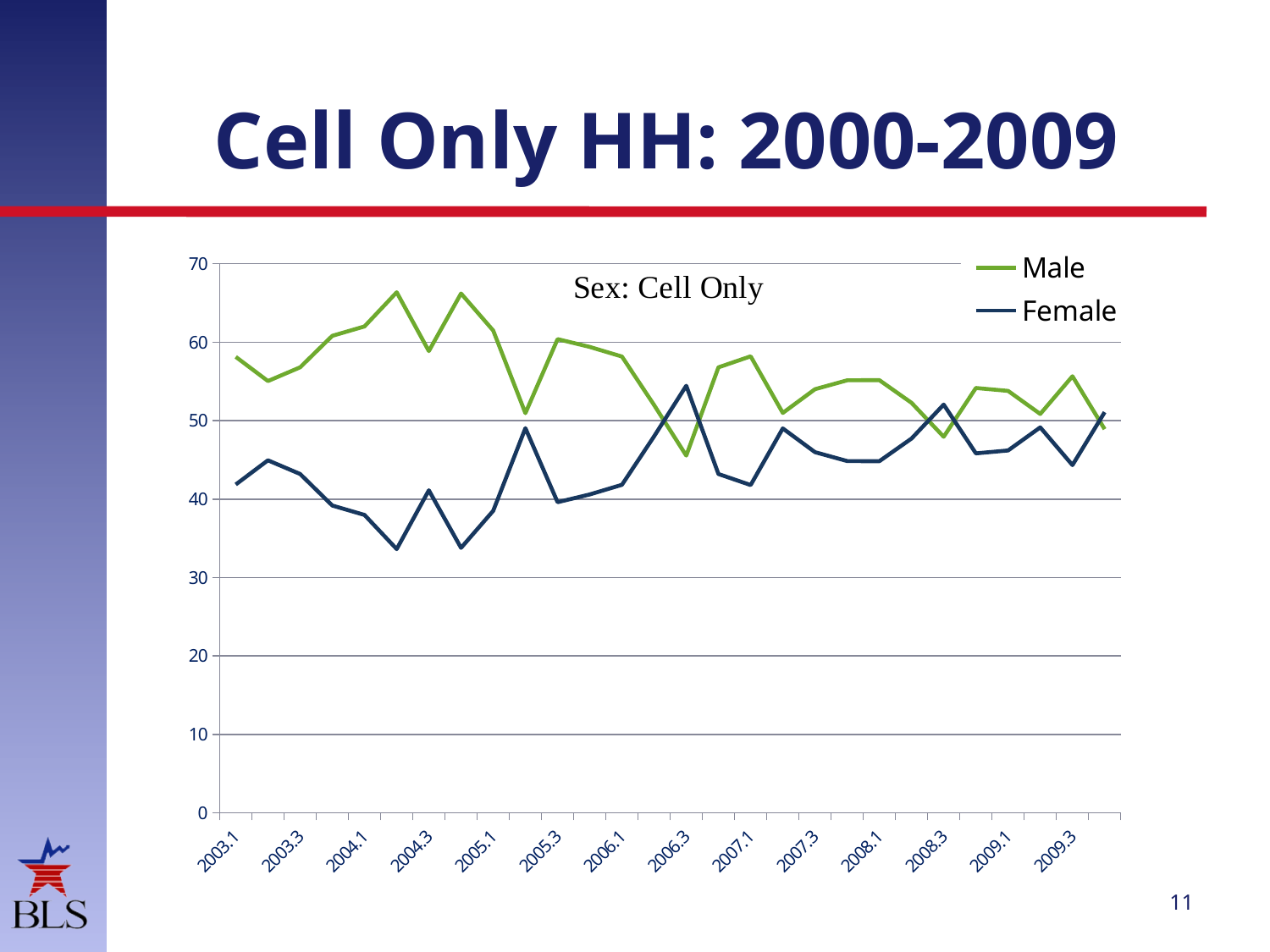
At 2003.1, which series has the larger value, Male or Female? Male Does the Female line generally rise or fall from 2003.1 to 2009.3? rise How many series does the legend list? 2 Which series is drawn in green? Male Is the value for Male at 2003.1 greater or less than 50? greater Is the value for Male at 2006.3 greater or less than 50? less What is the title shown inside the chart? Sex: Cell Only Is the value for Female at 2006.3 greater or less than 50? greater At 2006.3, which series has the larger value, Male or Female? Female What kind of chart is shown on the slide? line chart